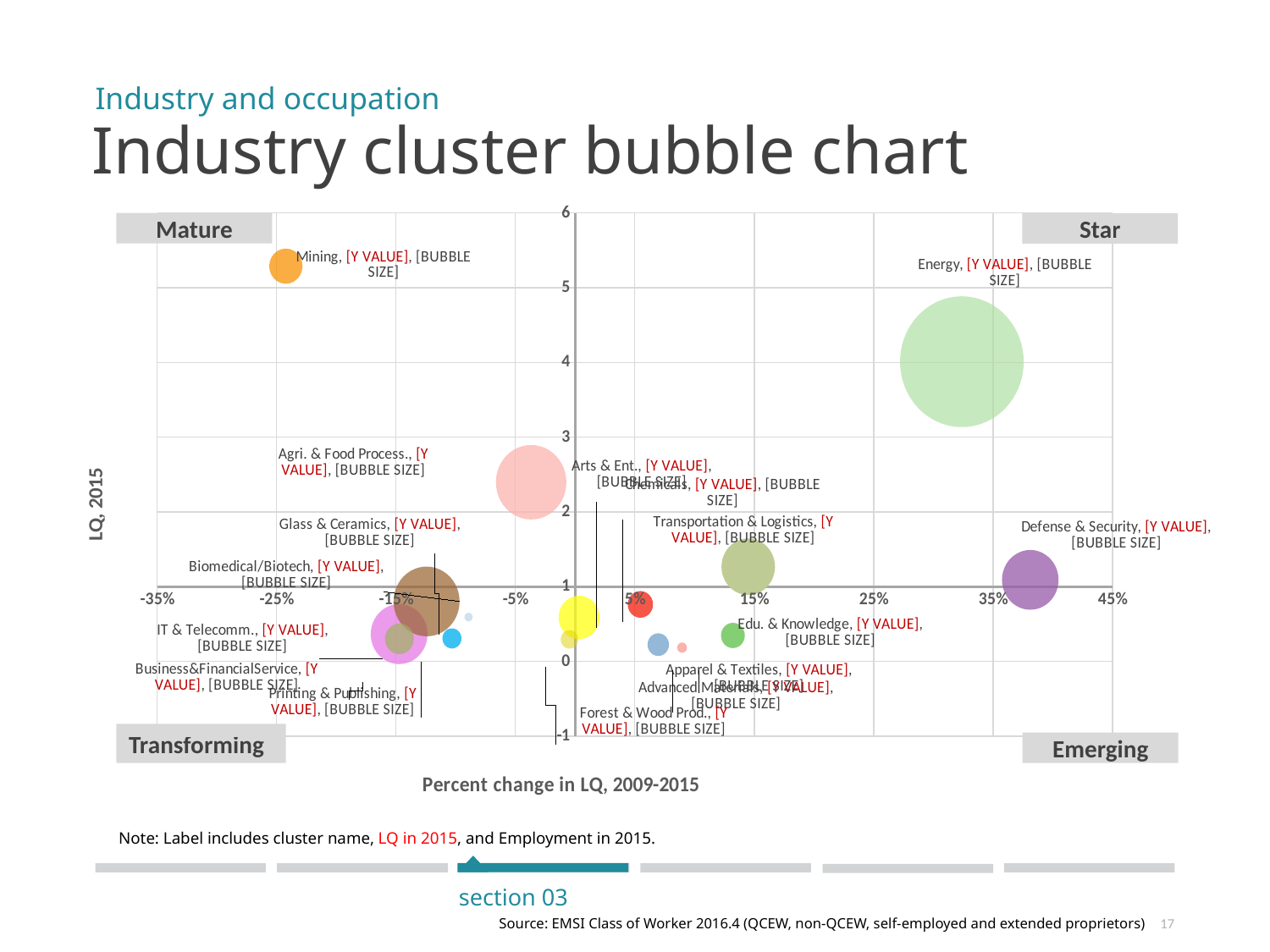
Is the percent change in LQ for Energy greater or less than 25%? greater Is the LQ, 2015 value for Mining greater or less than 4? greater Is the LQ, 2015 value for Agri. & Food Process. greater or less than 2? greater Which has a higher percent change in LQ, 2009-2015, Energy or Mining? Energy Which industry cluster is drawn with the largest bubble? Energy What kind of chart is shown on the slide? bubble chart Which industry cluster has the highest LQ in 2015 on the bubble chart? Mining Which has a higher LQ in 2015, Energy or Defense & Security? Energy What is the title of the x axis of the bubble chart? Percent change in LQ, 2009-2015 Which quadrant label is the Energy bubble located in? Star